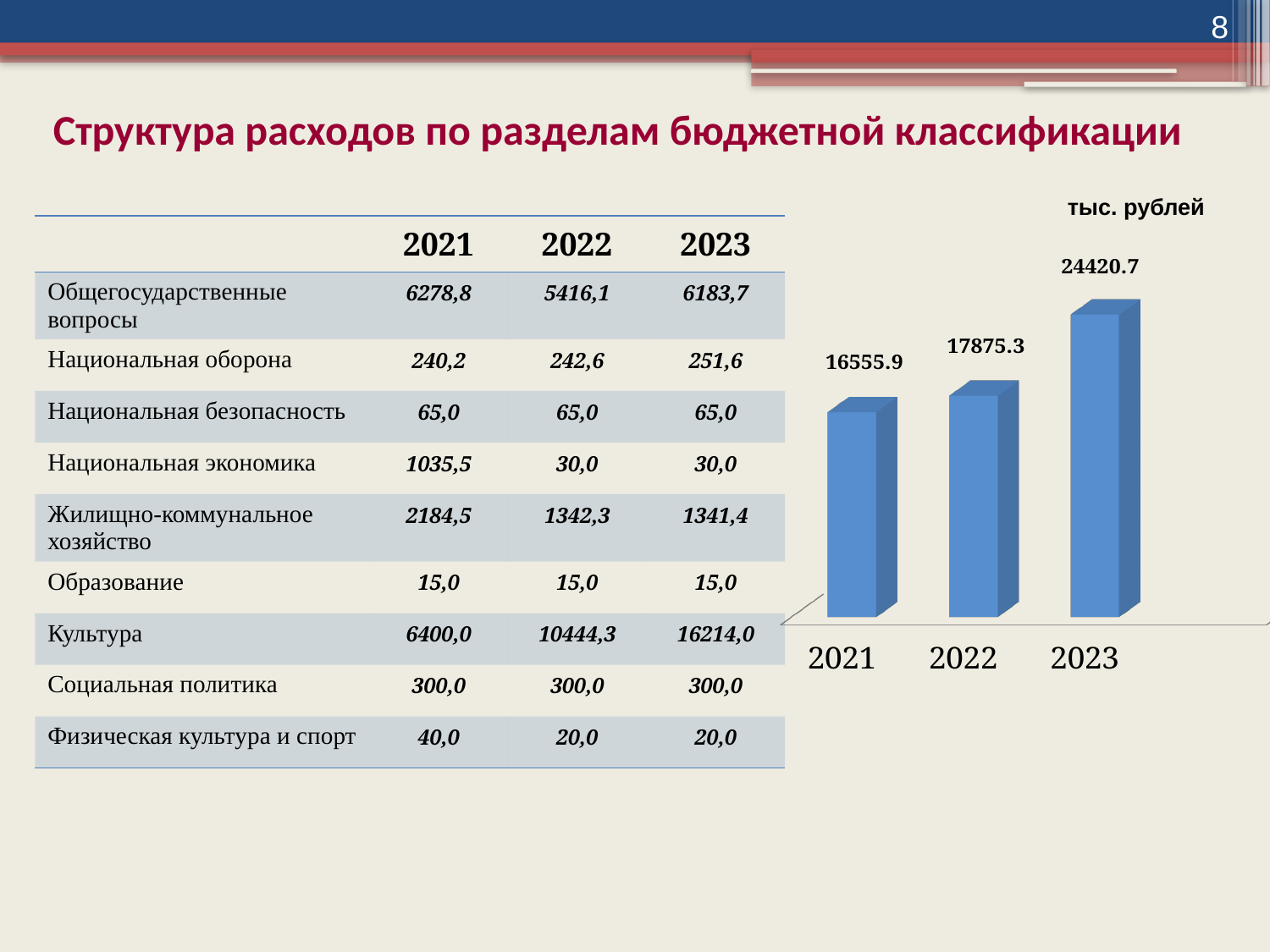
What is the value shown for 2023 in the bar chart? 24420.7 What is the difference between the 2022 and 2021 values in the bar chart? 1319.4 What kind of chart is shown on the right of the slide? bar chart How many bars are shown in the bar chart? 3 What is the difference between the 2023 and 2022 values in the bar chart? 6545.4 In the bar chart, which is larger: the value for 2022 or the value for 2023? 2023 Which year has the lowest value in the bar chart? 2021 What is the value shown for 2021 in the bar chart? 16555.9 Which year has the highest value in the bar chart? 2023 What is the difference between the 2023 and 2021 values in the bar chart? 7864.8 Do the values in the bar chart rise or fall from 2021 to 2023? rise What is the value shown for 2022 in the bar chart? 17875.3